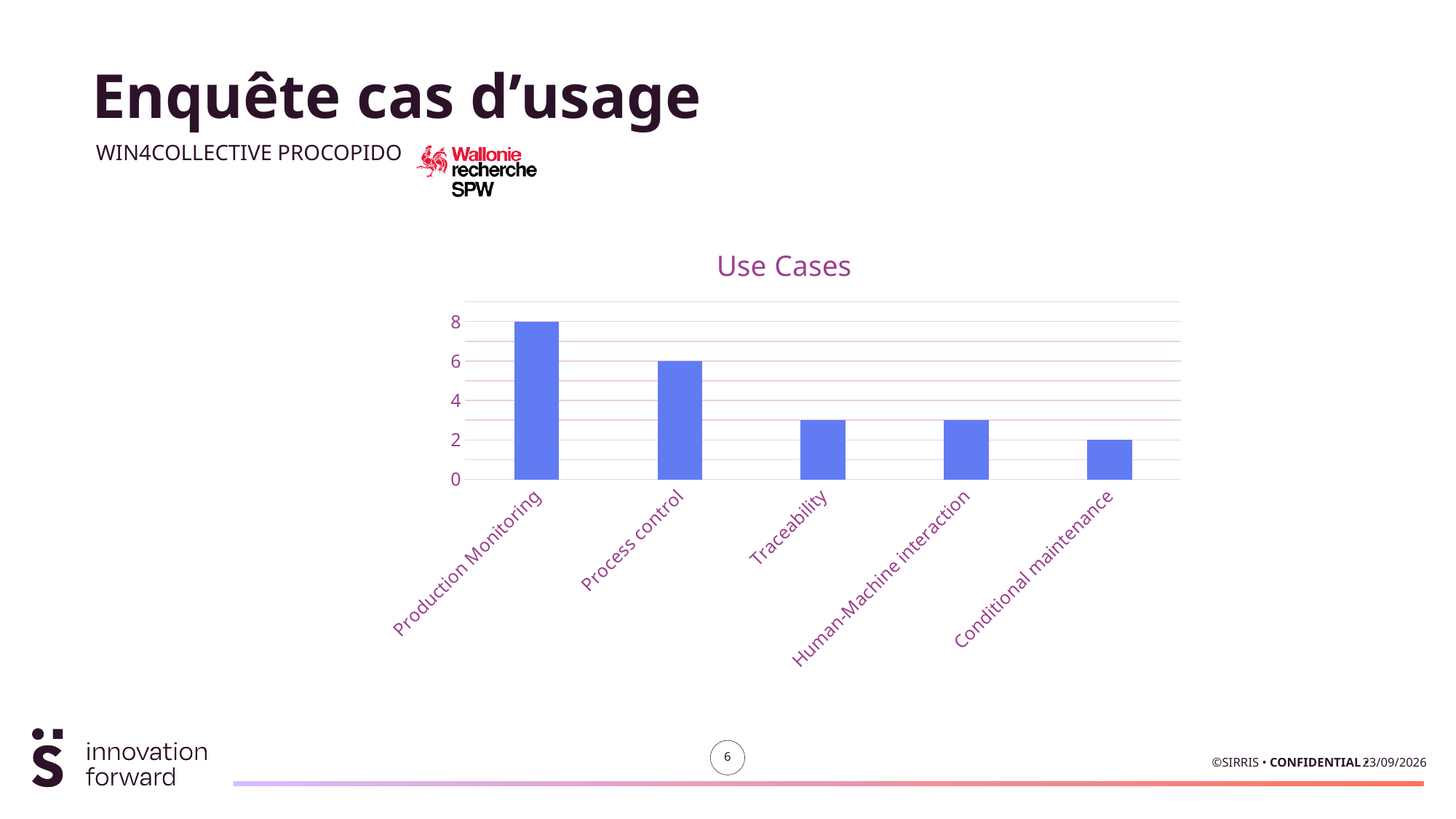
What is the value for Conditional maintenance? 2 Which is larger, the value for Process control or the value for Conditional maintenance? Process control How many categories are shown in the chart? 5 Do the values generally rise or fall from left to right across the categories? fall Which category has the lowest value? Conditional maintenance Which category has the highest value? Production Monitoring What type of chart is shown on the slide? bar chart What is the value for Process control? 6 What is the title of the chart? Use Cases What is the value for Production Monitoring? 8 Is the value for Traceability greater or less than 4? less What is the difference between the values for Production Monitoring and Process control? 2